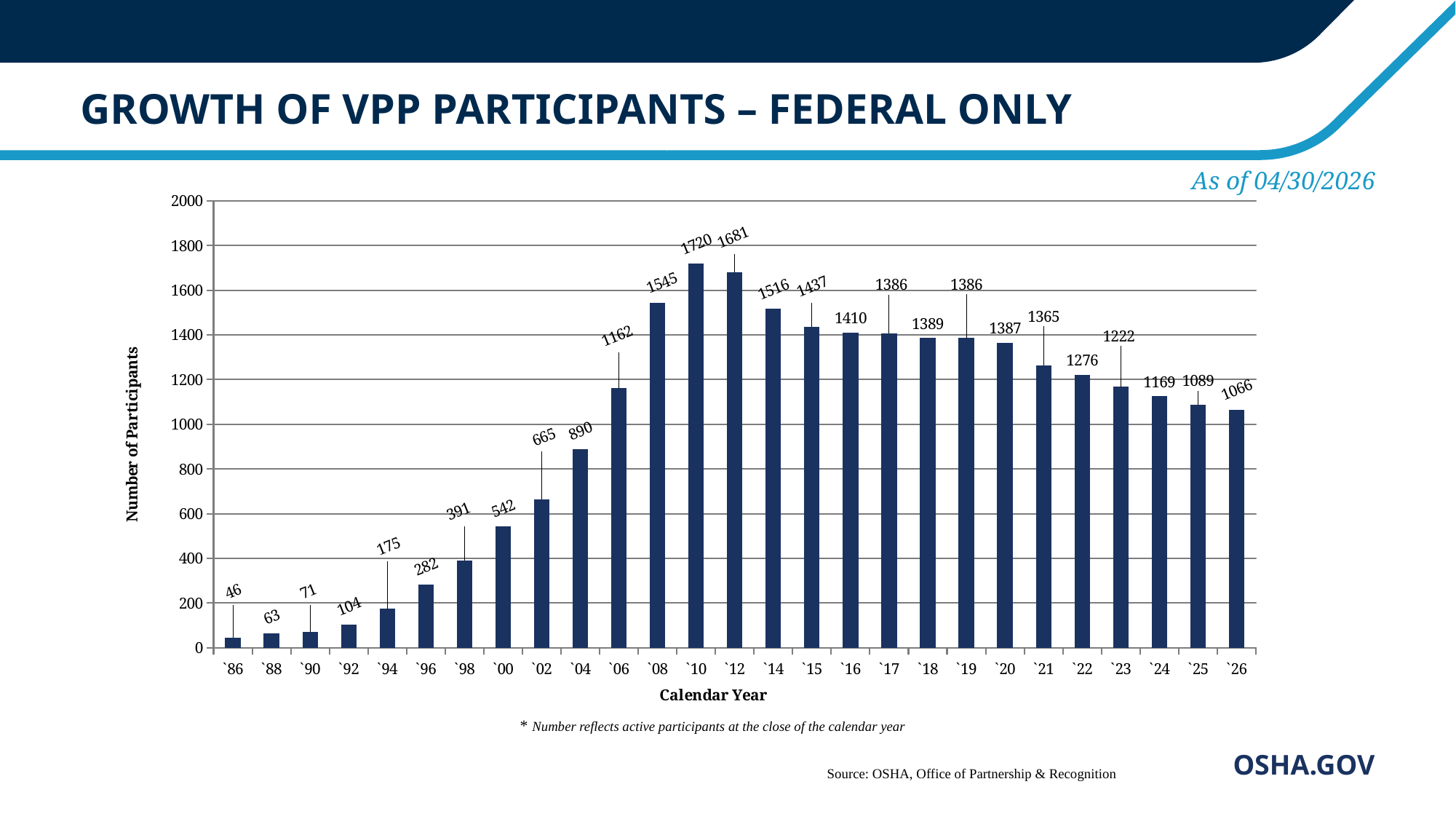
What is the difference in participants between `08 and `06? 383 What type of chart is shown on the slide? Bar chart What is the number of participants for `26? 1066 What is the value shown for `98? 391 What is the difference in participants between `10 and `12? 39 How many calendar years (bars) are plotted on the chart? 27 Do the values rise or fall from `10 to `26? Fall Which calendar year has the lowest number of participants? `86 Which calendar year has the highest number of participants? `10 What is the title of the vertical axis? Number of Participants How many participants are shown for calendar year `10? 1720 Which year has more participants, `06 or `22? `22